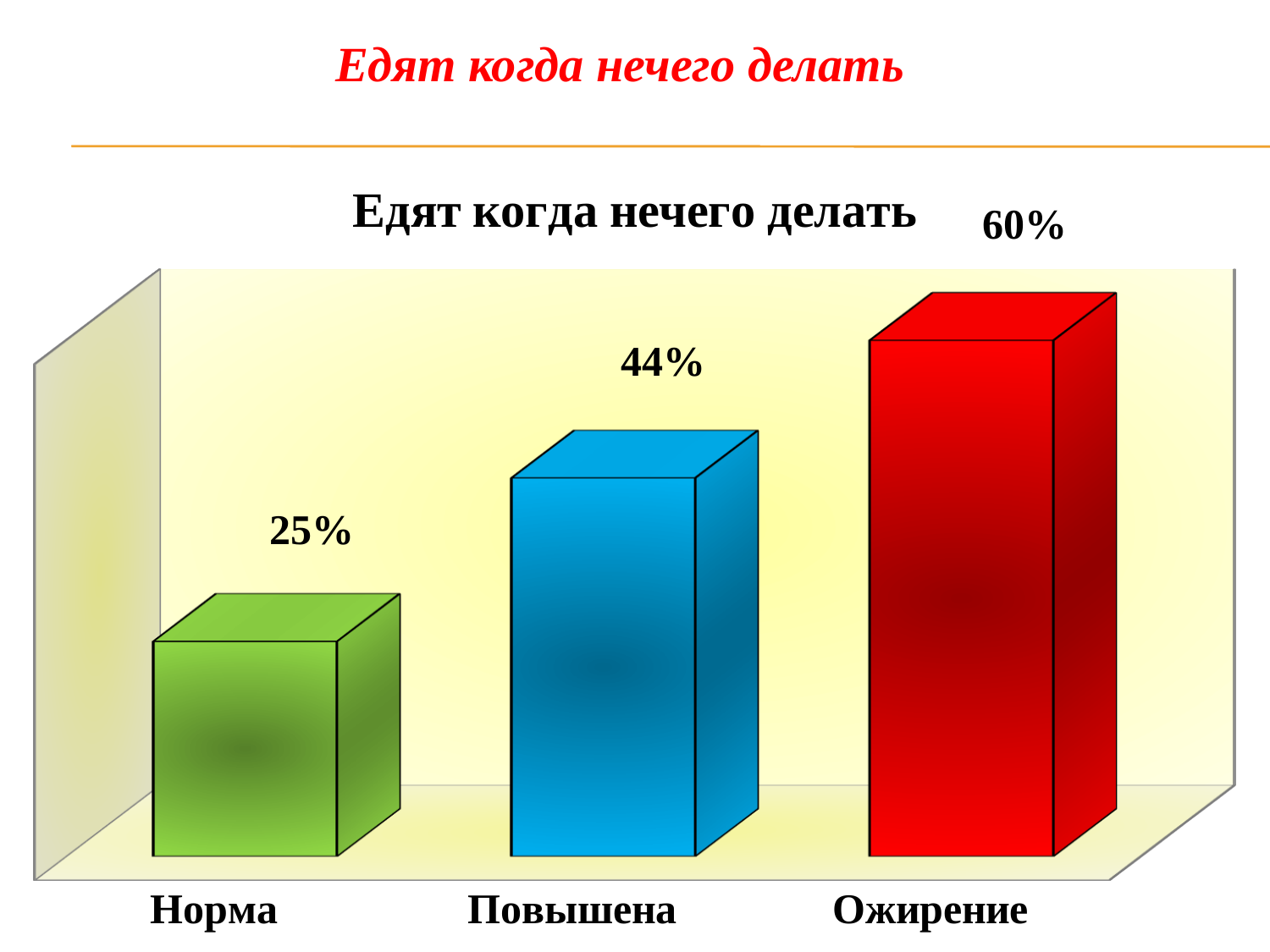
What is the difference between the values for Ожирение and Норма? 35% What is the value for Ожирение? 60% What is the value for Повышена? 44% How many categories are shown in the chart? 3 Do the values rise or fall from left to right across the categories? rise Which is larger, the value for Повышена or the value for Ожирение? Ожирение Which category has the lowest value? Норма What is the difference between the values for Повышена and Норма? 19% Which category has the highest value? Ожирение What kind of chart is shown on the slide? bar chart What is the value for Норма? 25% What is the title of the chart? Едят когда нечего делать